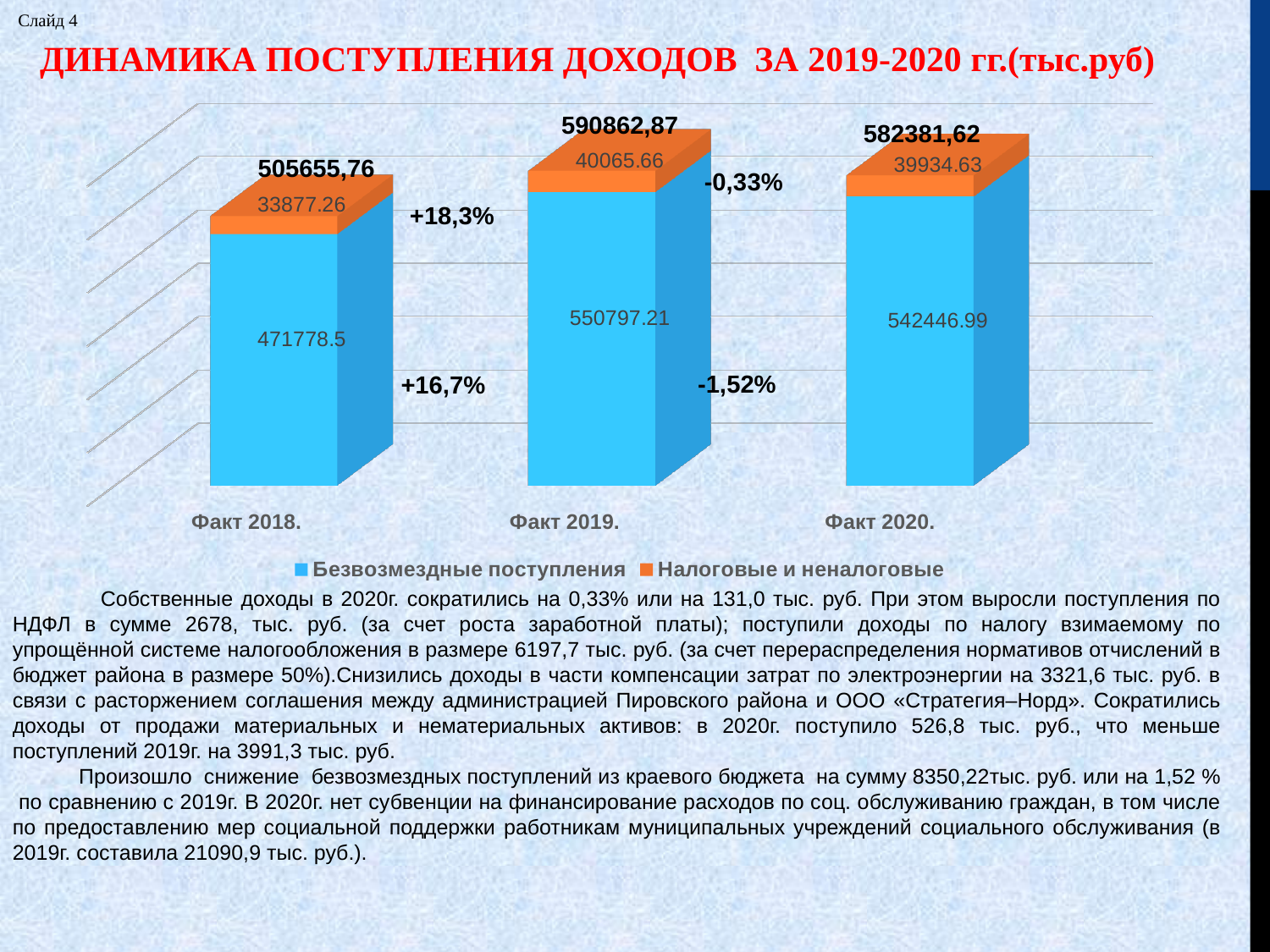
What type of chart is shown on the slide? Stacked bar chart Which category has the highest total? Факт 2019. How many categories are shown on the x axis of the chart? 3 What is the value of Налоговые и неналоговые for Факт 2020.? 39934.63 What is the value of Налоговые и неналоговые for Факт 2018.? 33877.26 Which category has the lowest value for Безвозмездные поступления? Факт 2018. Which series is shown in orange in the chart? Налоговые и неналоговые What is the total shown above the bar for Факт 2020.? 582381,62 Which is larger: Безвозмездные поступления for Факт 2019. or for Факт 2020.? Факт 2019. What is the difference between the Безвозмездные поступления values for Факт 2019. and Факт 2018.? 79018.71 How many series does the chart legend list? 2 What is the value of Безвозмездные поступления for Факт 2019.? 550797.21